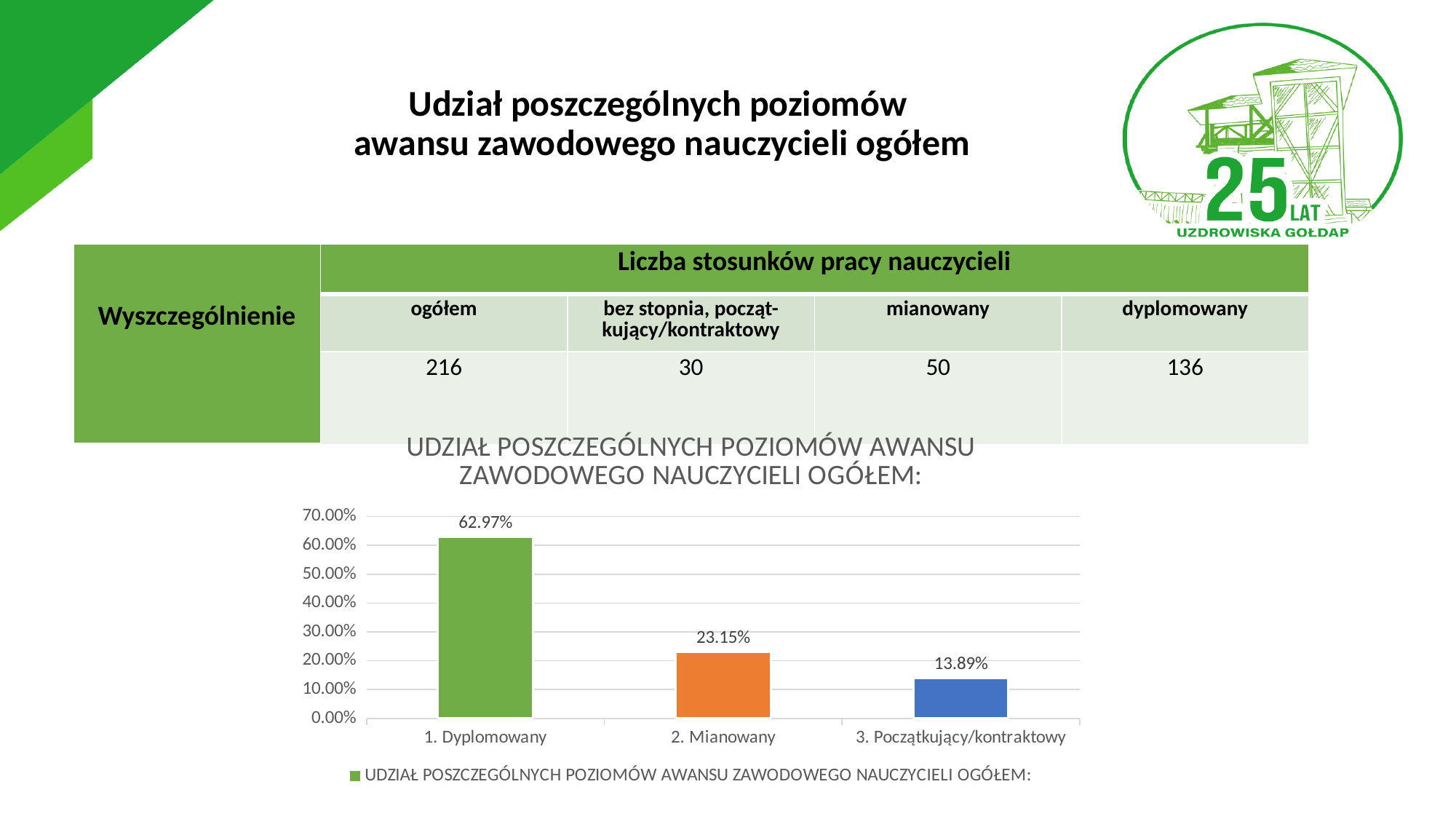
Do the values rise or fall from left to right across the categories? fall What is the value for 2. Mianowany in the chart? 23.15% What is the value for 1. Dyplomowany in the chart? 62.97% Which is larger, the value for 2. Mianowany or the value for 3. Początkujący/kontraktowy? 2. Mianowany What kind of chart is shown on the slide? bar chart How many categories are shown in the chart? 3 Is the value for 1. Dyplomowany greater or less than 60.00%? greater Which category has the highest value in the chart? 1. Dyplomowany What is the difference between the values for 2. Mianowany and 3. Początkujący/kontraktowy? 9.26% What is the difference between the values for 1. Dyplomowany and 2. Mianowany? 39.82% What is the value for 3. Początkujący/kontraktowy in the chart? 13.89% Which category has the lowest value in the chart? 3. Początkujący/kontraktowy